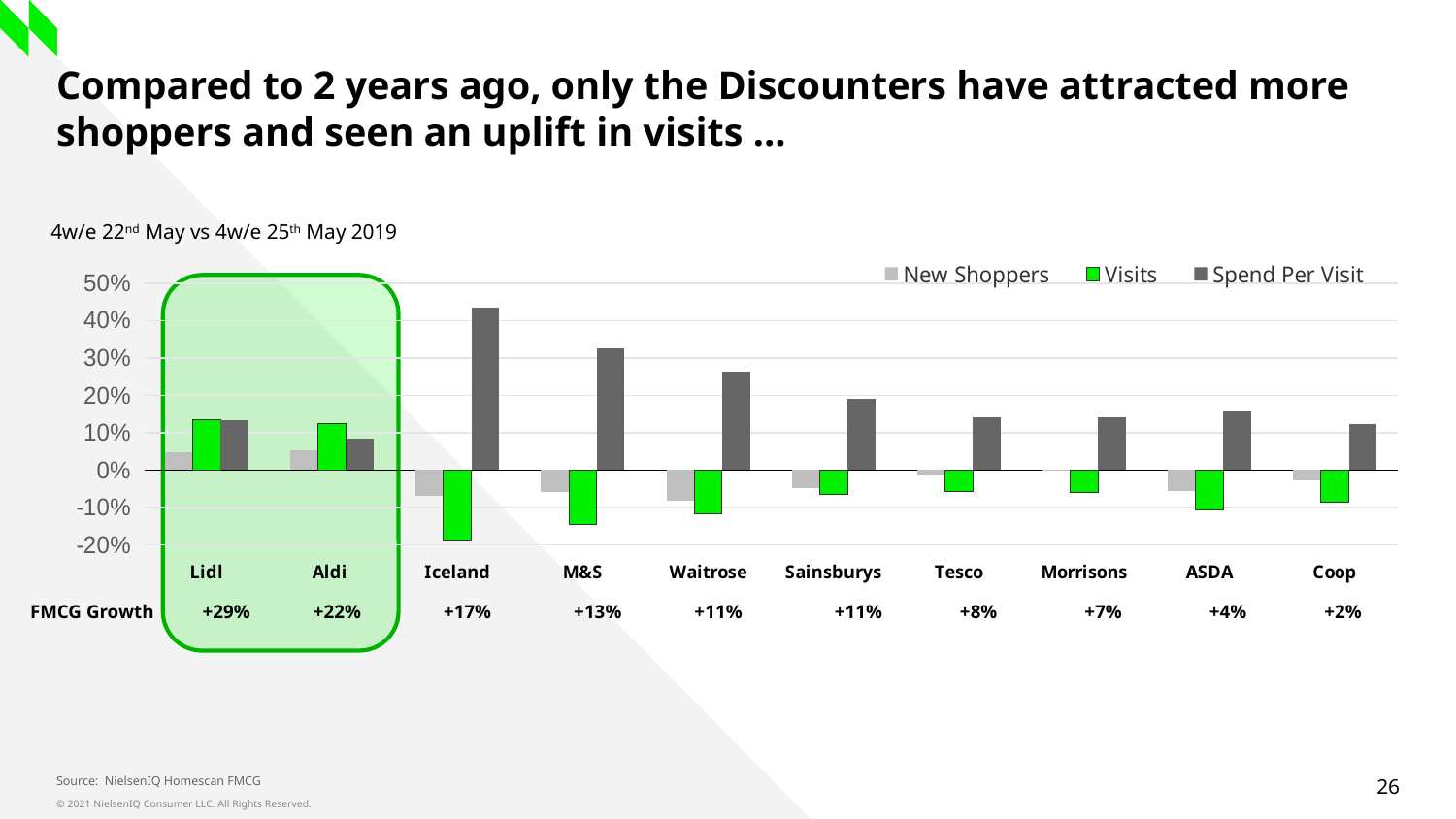
Which retailer has the lowest Visits value? Iceland Do the FMCG Growth figures rise or fall moving from left to right across the retailers? fall How many retailers are shown on the x axis of the chart? 10 Is the Spend Per Visit value for Waitrose greater or less than 20%? greater Which is larger, the Spend Per Visit value for Lidl or for Aldi? Lidl What kind of chart is shown on the slide? bar chart Is the Spend Per Visit value for Iceland greater or less than 30%? greater Which retailer has the highest Spend Per Visit value? Iceland Is the Visits value for Iceland greater or less than -10%? less How many series does the chart legend list? 3 What is the FMCG Growth figure shown for Coop? +2% What is the FMCG Growth figure shown for Lidl? +29%